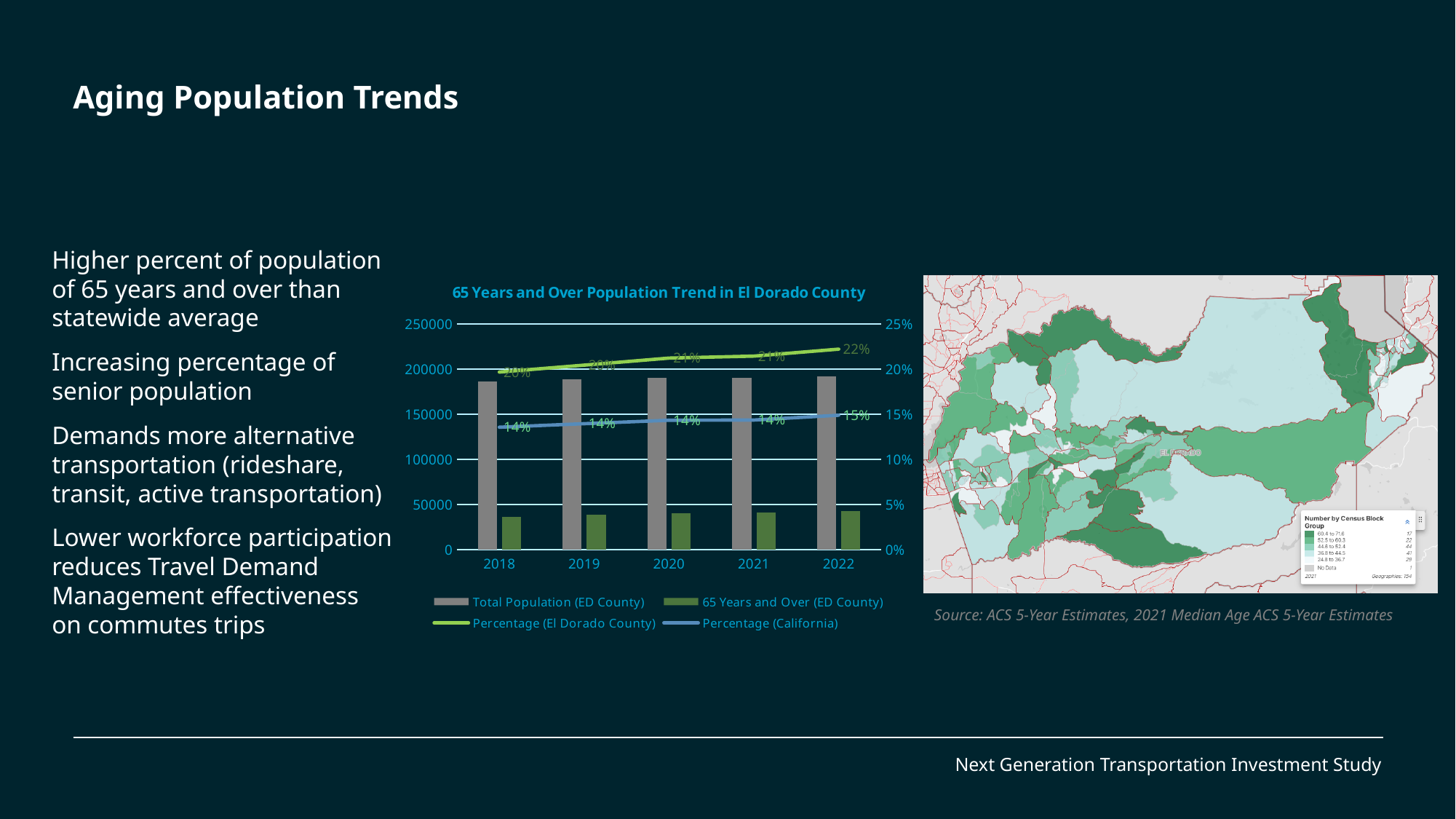
What is the Percentage (El Dorado County) value for 2022? 22% Is the Total Population (ED County) value for 2018 greater or less than 150000? greater Which is larger in 2018: the Percentage (El Dorado County) or the Percentage (California)? Percentage (El Dorado County) In which year is the Percentage (El Dorado County) highest? 2022 How many years are shown on the x axis of the chart? 5 What is the difference between the Percentage (El Dorado County) and the Percentage (California) in 2022? 7 percentage points Does the Percentage (El Dorado County) rise or fall from 2018 to 2022? rise What is the Percentage (El Dorado County) value for 2020? 21% Is the 65 Years and Over (ED County) value for 2022 greater or less than 50000? less How many series does the chart legend list? 4 What is the Percentage (California) value for 2022? 15% What is the Percentage (California) value for 2018? 14%